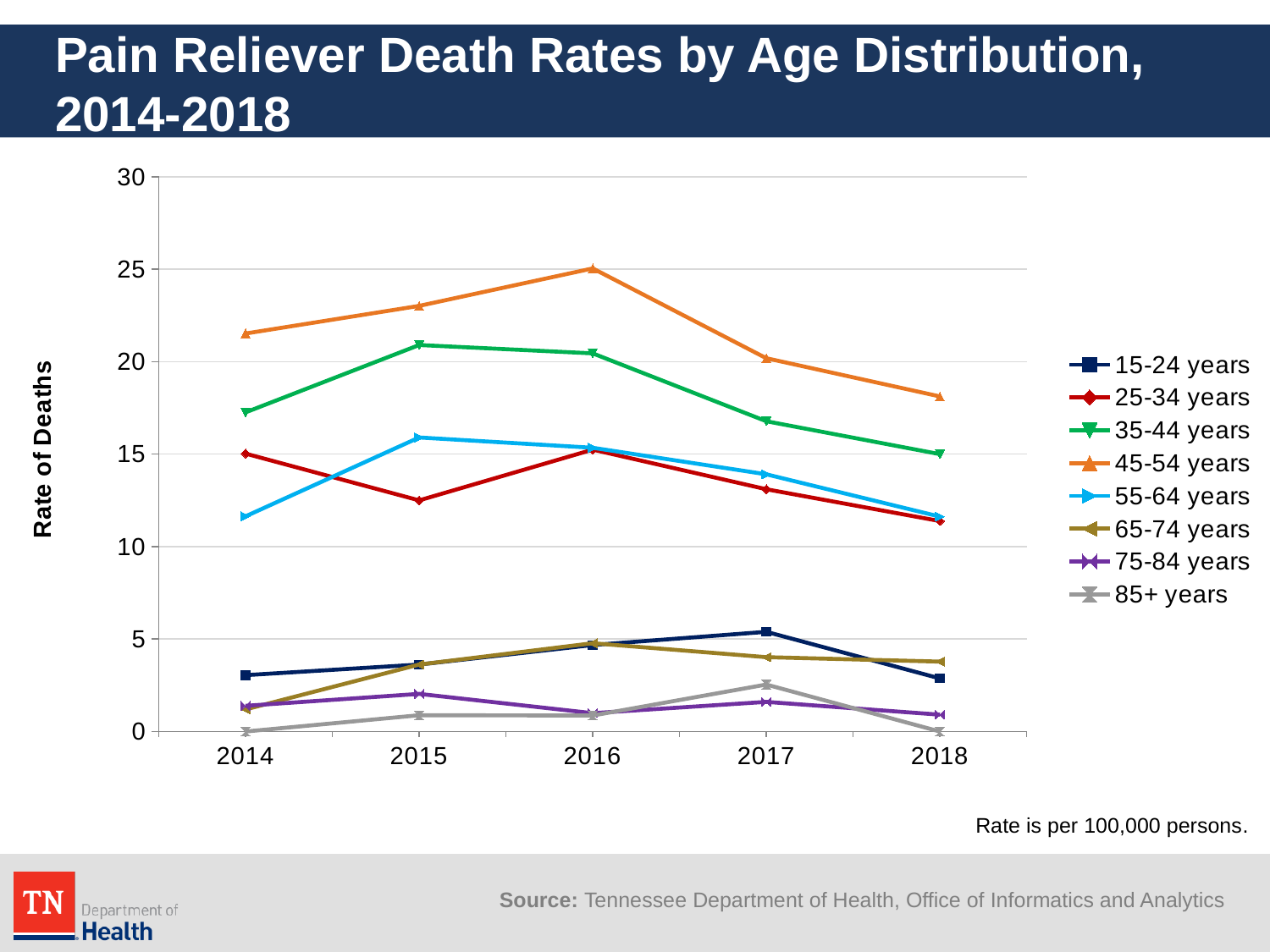
How many series does the legend list? 8 Which age group has the lowest pain reliever death rate in 2014? 85+ years Does the death rate for the 45-54 years group rise or fall from 2016 to 2018? fall Which age group has the highest pain reliever death rate in 2016? 45-54 years Is the value for 25-34 years in 2015 greater or less than 15? less Is the value for 55-64 years in 2014 greater or less than 10? greater What kind of chart is shown on the slide? line chart Which is larger in 2015, the value for 35-44 years or the value for 55-64 years? 35-44 years Is the value for 45-54 years in 2014 greater or less than 20? greater How many years are shown along the x axis? 5 What is the death rate for the 85+ years group in 2018? 0